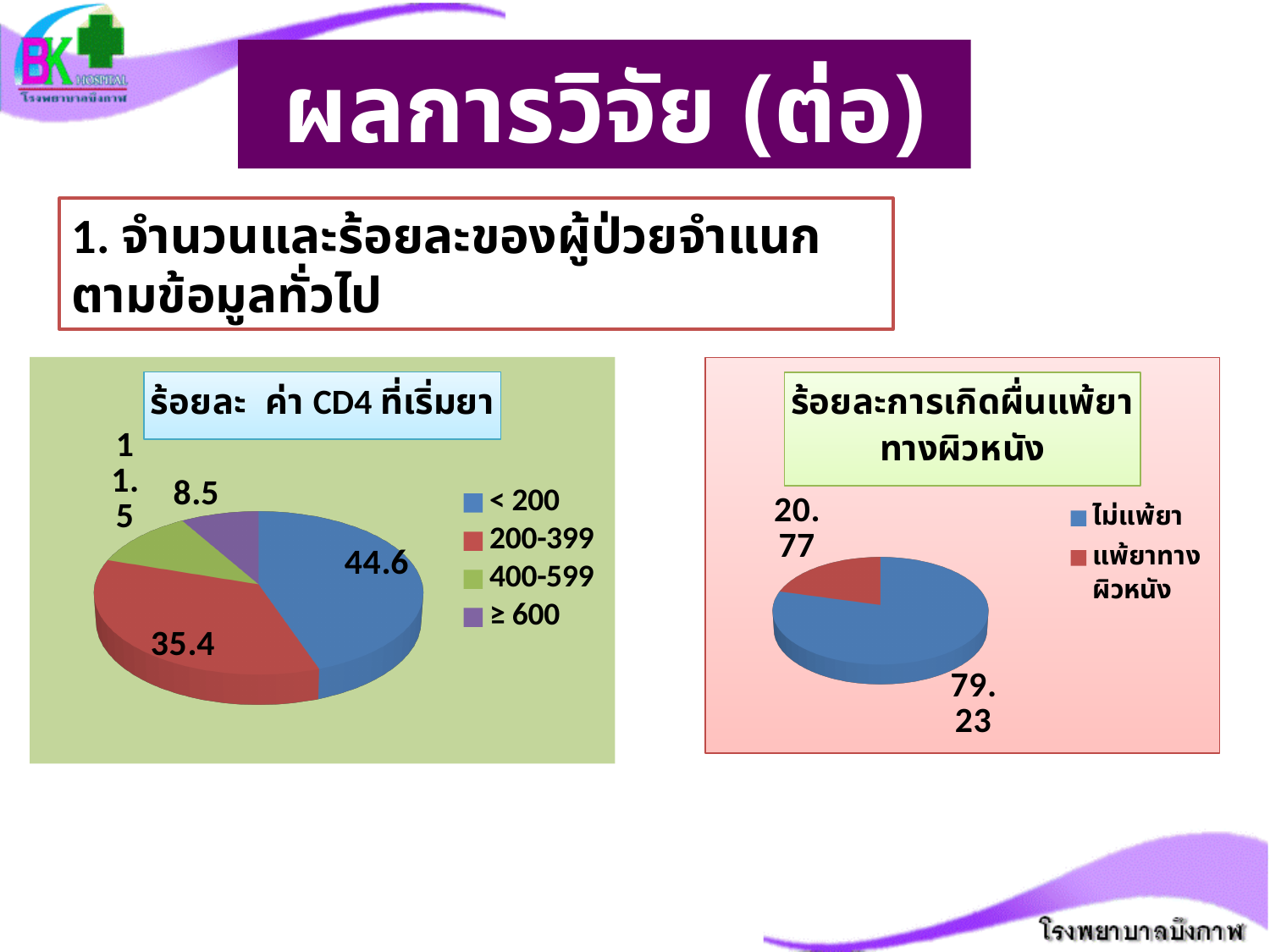
What type of chart is the left chart (ร้อยละ ค่า CD4 ที่เริ่มยา)? Pie chart In the left chart (ร้อยละ ค่า CD4 ที่เริ่มยา), what is the value for the < 200 category? 44.6 In the left chart (ร้อยละ ค่า CD4 ที่เริ่มยา), what is the value for the ≥ 600 category? 8.5 In the left chart (ร้อยละ ค่า CD4 ที่เริ่มยา), how many categories does the pie have? 4 In the left chart (ร้อยละ ค่า CD4 ที่เริ่มยา), which category has the largest share? < 200 In the left chart (ร้อยละ ค่า CD4 ที่เริ่มยา), what is the difference between the < 200 and 200-399 values? 9.2 In the right chart (ร้อยละการเกิดผื่นแพ้ยาทางผิวหนัง), how many entries does the legend list? 2 In the left chart (ร้อยละ ค่า CD4 ที่เริ่มยา), what is the value for the 200-399 category? 35.4 In the right chart (ร้อยละการเกิดผื่นแพ้ยาทางผิวหนัง), what is the value for แพ้ยาทางผิวหนัง? 20.77 In the right chart (ร้อยละการเกิดผื่นแพ้ยาทางผิวหนัง), which is larger, ไม่แพ้ยา or แพ้ยาทางผิวหนัง? ไม่แพ้ยา In the right chart (ร้อยละการเกิดผื่นแพ้ยาทางผิวหนัง), what is the value for ไม่แพ้ยา? 79.23 In the left chart (ร้อยละ ค่า CD4 ที่เริ่มยา), which category has the smallest share? ≥ 600